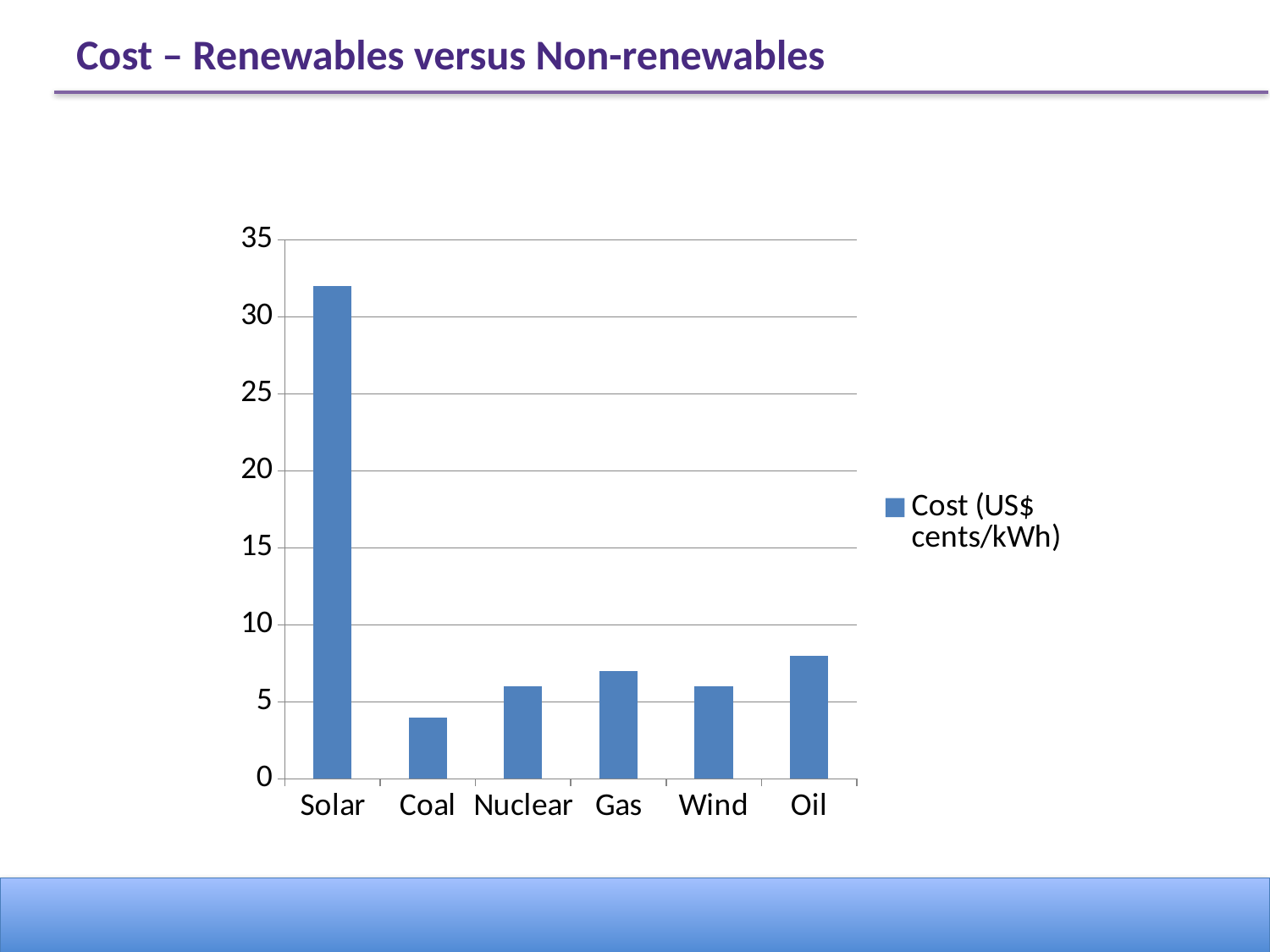
Which category has the highest cost in the chart? Solar Which has a higher cost, Coal or Wind? Wind Is the value for Solar greater or less than 30? greater Which has a higher cost, Solar or Oil? Solar What is the series name shown in the chart's legend? Cost (US$ cents/kWh) Is the value for Coal greater or less than 5? less How many series does the chart's legend list? 1 Which category has the lowest cost in the chart? Coal Is the value for Gas greater or less than 5? greater What kind of chart is shown on the slide? Bar chart How many categories are shown on the x axis of the chart? 6